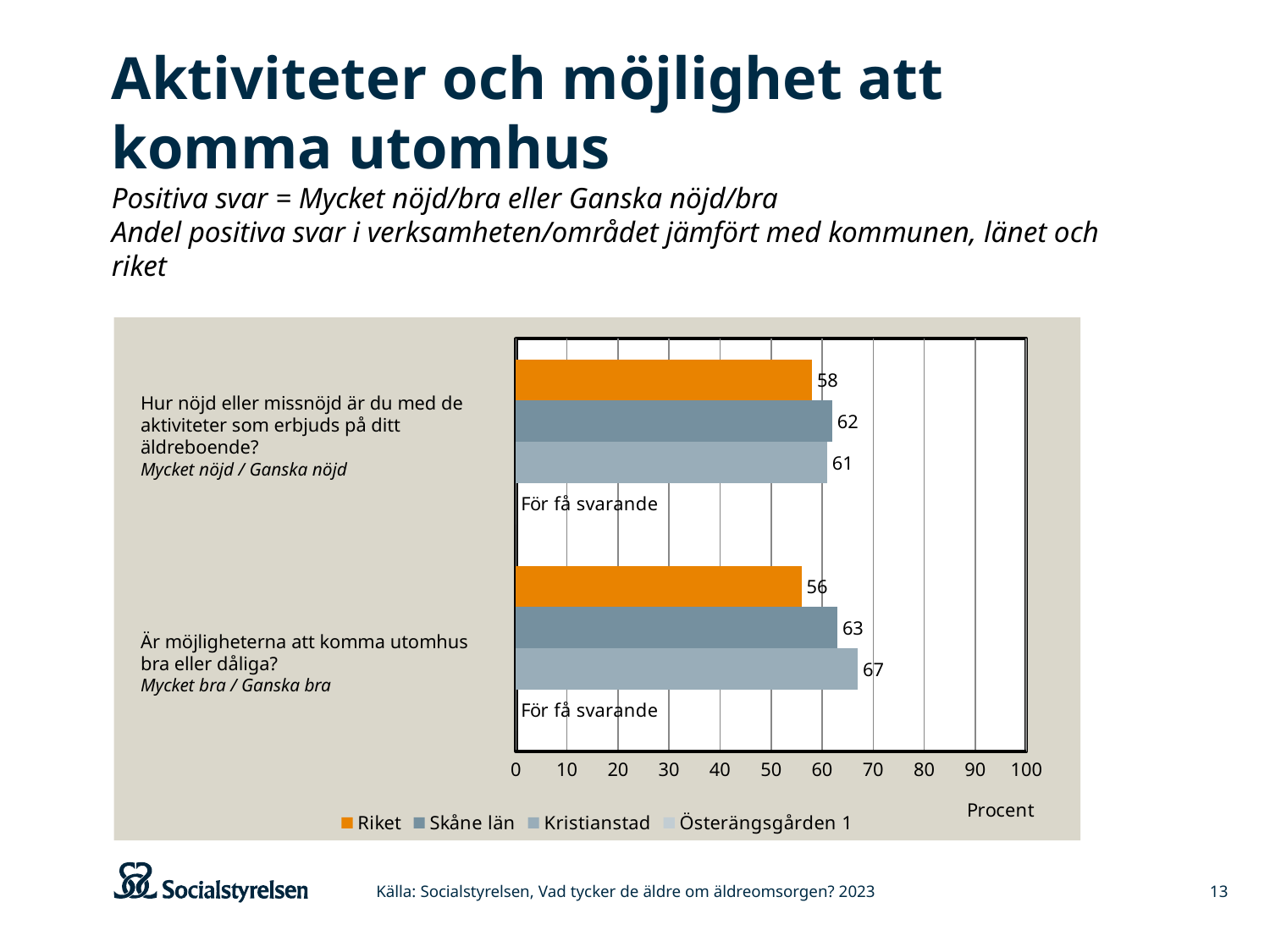
What is the value for Kristianstad on the question about opportunities to get outdoors (Är möjligheterna att komma utomhus bra eller dåliga?)? 67 Which is larger on the question about satisfaction with activities: Skåne län or Kristianstad? Skåne län How many series does the legend list? 4 What is the value for Riket on the question about satisfaction with activities offered at the care home (Hur nöjd eller missnöjd är du med de aktiviteter som erbjuds på ditt äldreboende?)? 58 Is the value for Riket on the question about opportunities to get outdoors greater or less than 60? less What is the value for Skåne län on the question about opportunities to get outdoors? 63 What kind of chart is shown on the slide? bar chart What is the difference between Kristianstad and Riket on the question about opportunities to get outdoors? 11 What is shown for Österängsgården 1 on the question about activities offered at the care home? För få svarande Which series has the highest value on the question about opportunities to get outdoors? Kristianstad What is the label of the horizontal axis? Procent Which series has the lowest value on the question about satisfaction with activities? Riket